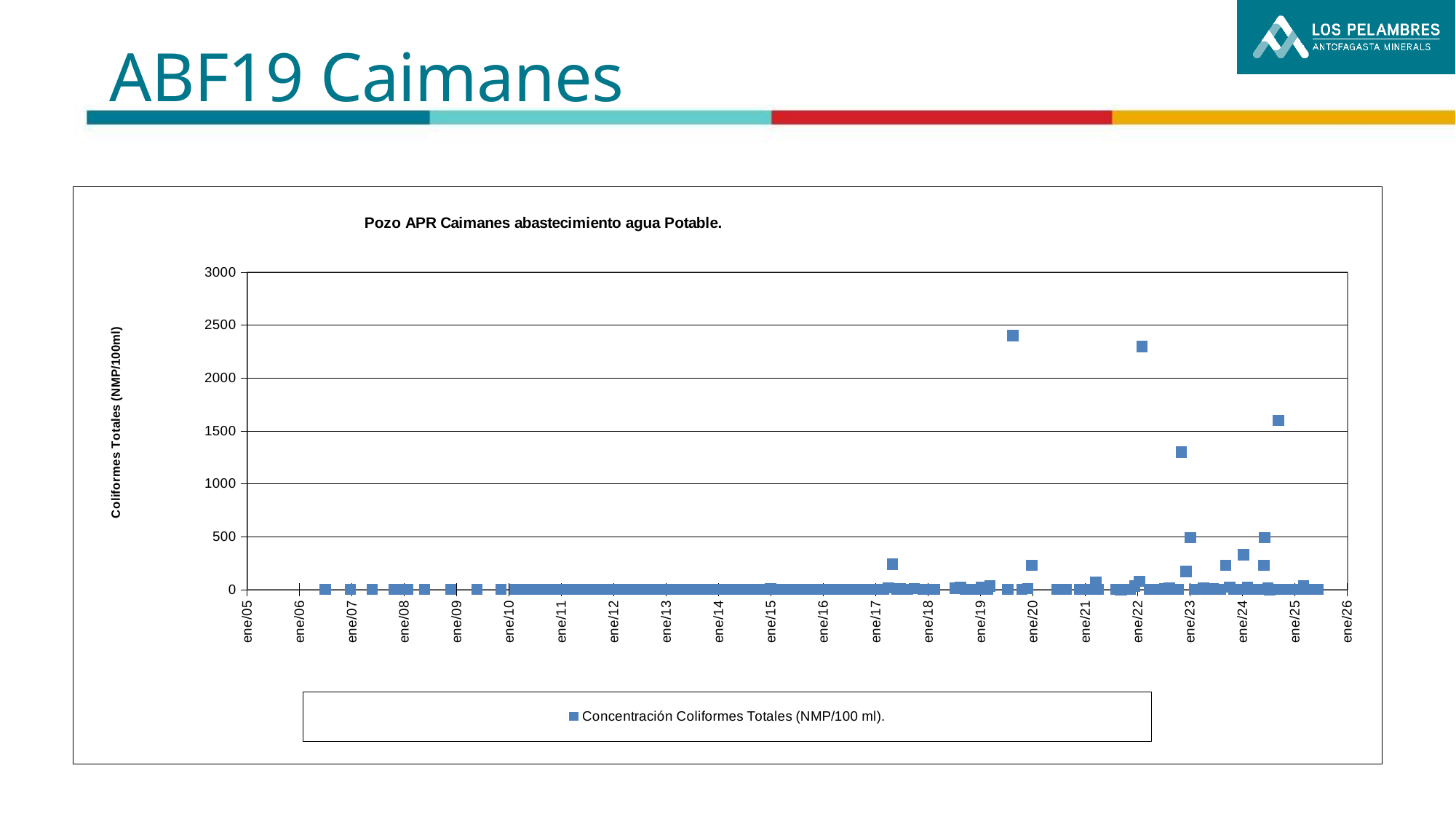
What is the label of the vertical axis? Coliformes Totales (NMP/100ml) How many points are plotted above 2000? 2 Is the highest plotted value greater or less than 2000? greater How many series does the legend list? 1 What is the highest value shown on the vertical axis? 3000 What kind of chart is shown on the slide? Scatter chart What is the title of the chart? Pozo APR Caimanes abastecimiento agua Potable. Is the highest point plotted between ene/22 and ene/23 greater or less than 1000? greater Is the highest plotted value greater or less than 2500? less How many points are plotted above 1000? 4